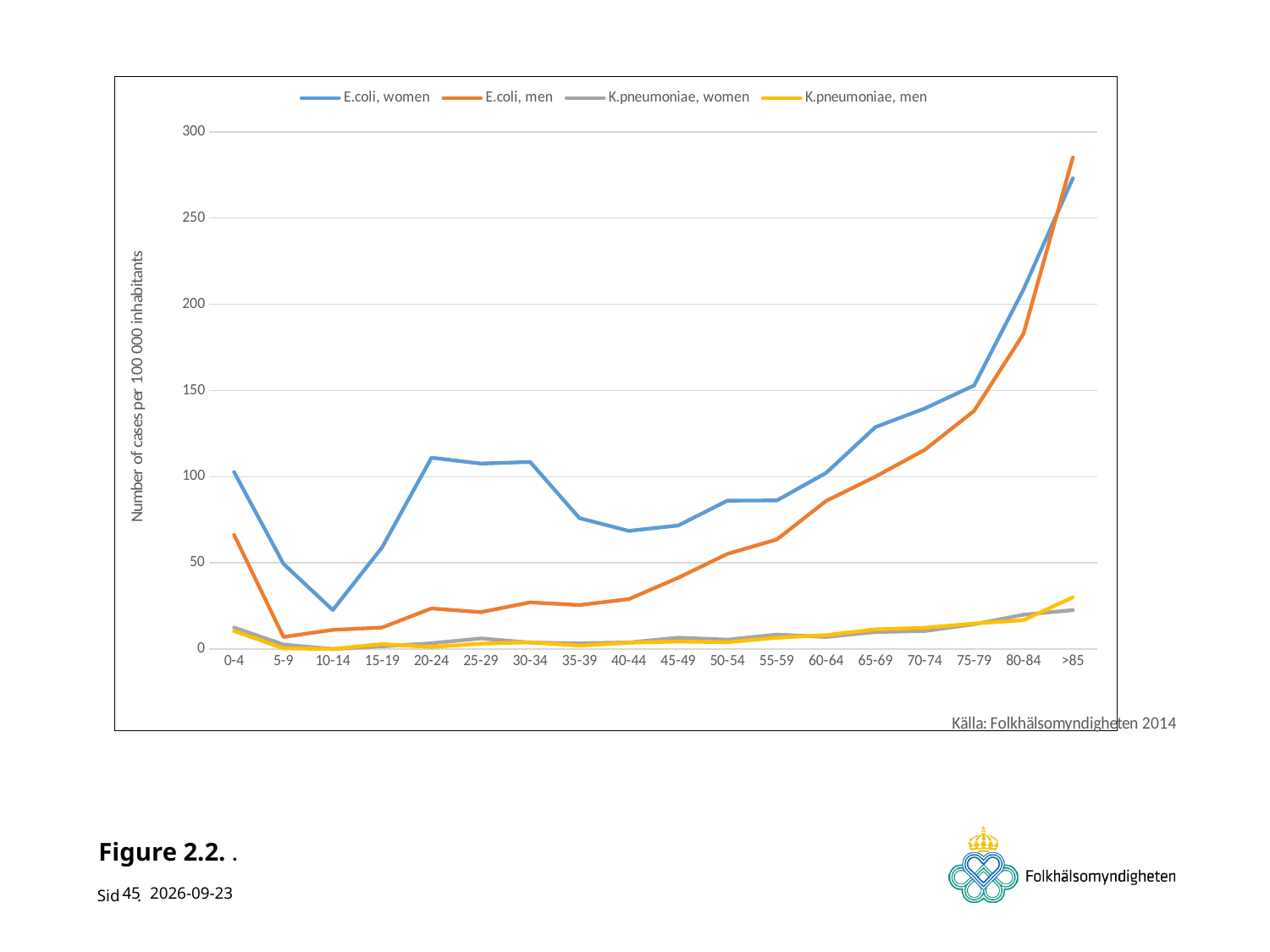
Is the value for K.pneumoniae, men in the >85 age group greater or less than 50? less Is the value for E.coli, men in the >85 age group greater or less than 250? greater How many age groups are shown along the x axis? 18 What is the label on the y axis? Number of cases per 100 000 inhabitants Does the E.coli, men line rise or fall from the 5-9 age group to the >85 age group? rise What kind of chart is shown on the slide? line chart How many series does the legend list? 4 Is the value for E.coli, men in the 0-4 age group greater or less than 50? greater In the 20-24 age group, which is larger: E.coli, women or E.coli, men? E.coli, women Which age group has the highest value for E.coli, women? >85 Which age group has the lowest value for E.coli, women? 10-14